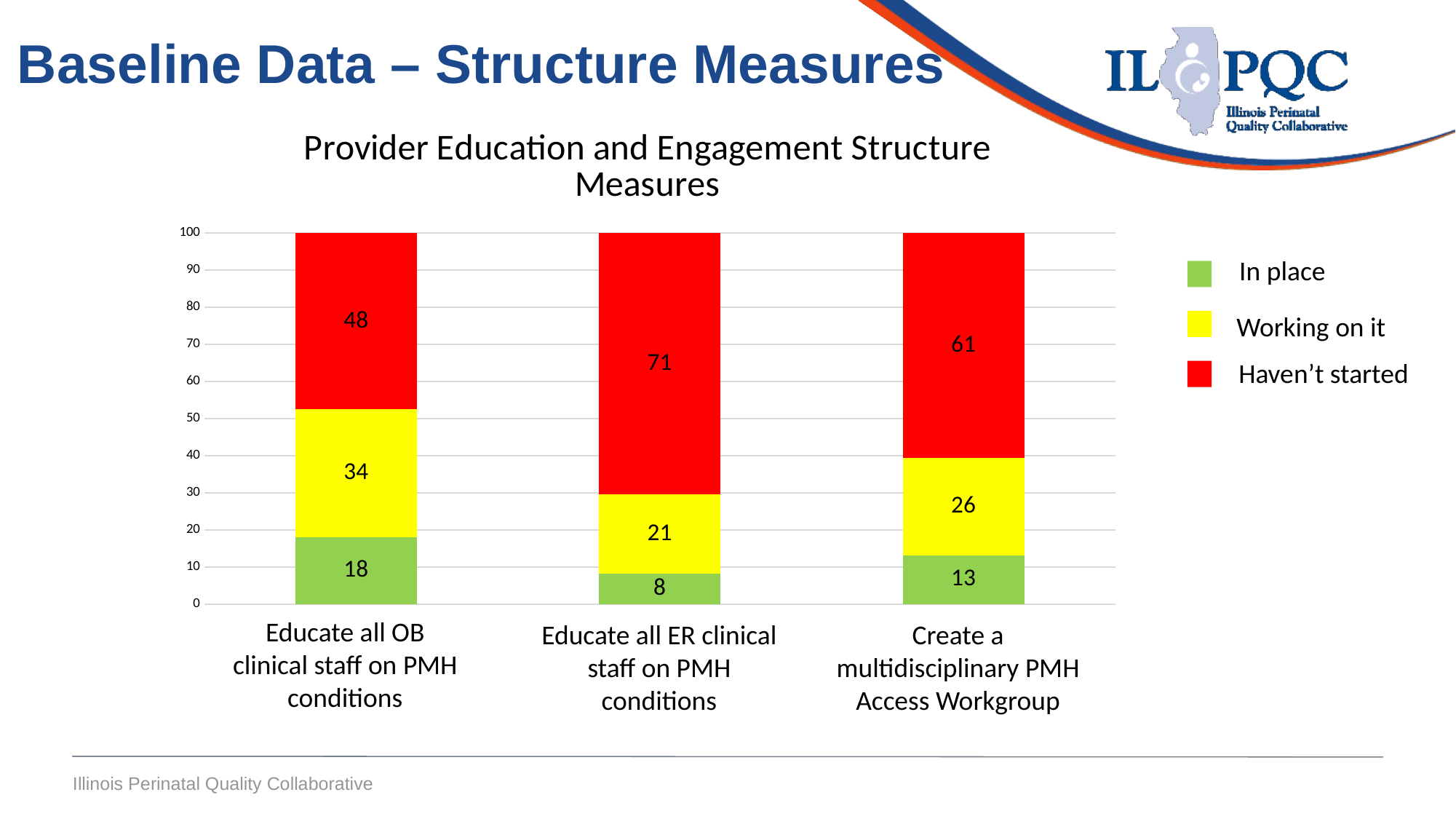
What is the difference between the 'Haven't started' values for 'Educate all ER clinical staff on PMH conditions' and 'Educate all OB clinical staff on PMH conditions'? 23 What is the 'Haven't started' value for 'Educate all ER clinical staff on PMH conditions'? 71 Which is larger: the 'Working on it' value for 'Educate all OB clinical staff on PMH conditions' or for 'Create a multidisciplinary PMH Access Workgroup'? Educate all OB clinical staff on PMH conditions Which category has the lowest 'In place' value? Educate all ER clinical staff on PMH conditions What is the total of the stacked bar for 'Educate all OB clinical staff on PMH conditions'? 100 What kind of chart is shown? Stacked bar chart What colour represents 'Haven't started' in the legend? Red How many series does the legend list? 3 Which category has the highest 'Haven't started' value? Educate all ER clinical staff on PMH conditions What is the 'In place' value for 'Educate all OB clinical staff on PMH conditions'? 18 How many categories are shown on the x axis? 3 What is the 'Working on it' value for 'Create a multidisciplinary PMH Access Workgroup'? 26